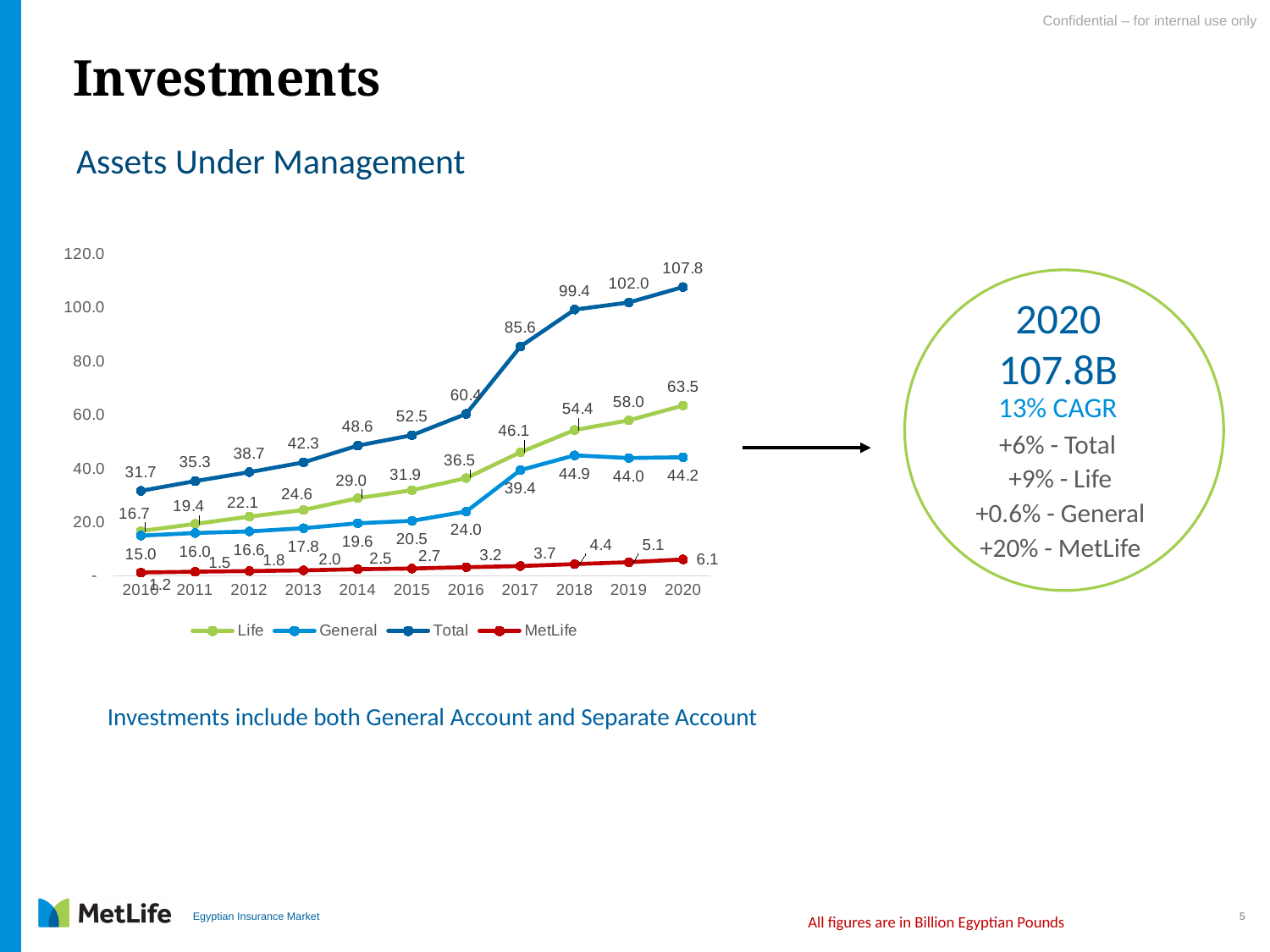
What is the Life value for 2018? 54.4 Does the Total series rise or fall from 2010 to 2020? rise What is the MetLife value for 2019? 5.1 In which year is the Life series at its lowest? 2010 How many series does the legend list? 4 Which is larger in 2015, the Life value or the General value? Life What is the Total value for 2020? 107.8 How many years are plotted on the x axis? 11 In which year is the Total series at its highest? 2020 What is the difference between the Total values for 2020 and 2019? 5.8 What is the General value for 2017? 39.4 What type of chart is shown on the slide? line chart